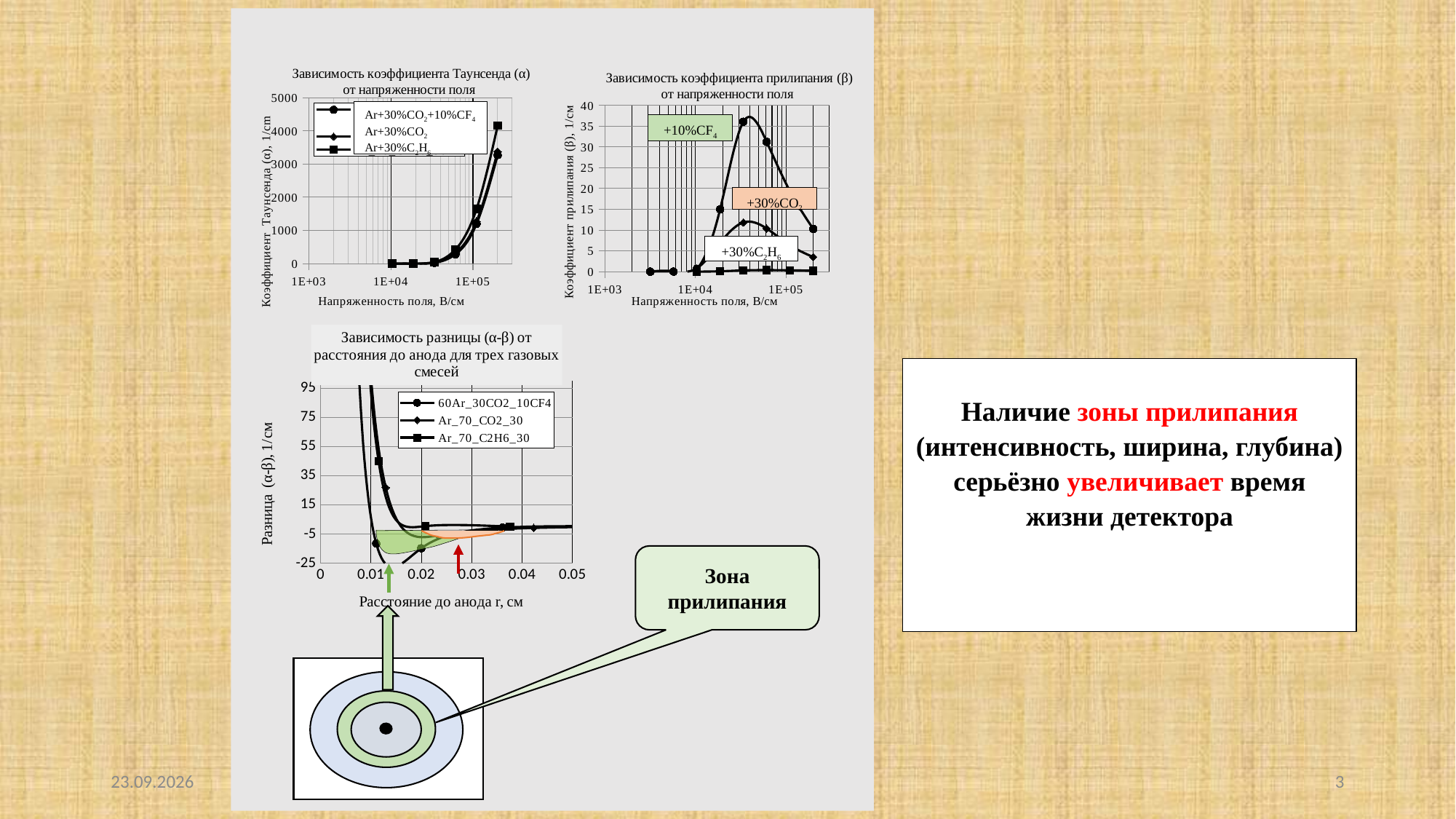
What kind of chart is the top-left chart titled "Зависимость коэффициента Таунсенда (α) от напряженности поля"? Line chart How many series does the legend of the top-left chart (Townsend coefficient α) list? 3 In the top-left chart (Townsend coefficient α), which series reaches the highest value at the right end of the x axis? Ar+30%C2H6 In the top-right chart (attachment coefficient β), is the peak value of the +30%CO2 curve greater or less than 15? less In the top-right chart (attachment coefficient β), is the peak value of the +10%CF4 curve greater or less than 30? greater What is the title of the top-right chart? Зависимость коэффициента прилипания (β) от напряженности поля In the bottom chart (difference α-β), is the value of the Ar_70_C2H6_30 series at r = 0.01 greater or less than 35? greater In the top-right chart (attachment coefficient β), which gas mixture has the highest peak value? +10%CF4 What is the x-axis label of the bottom chart (difference α-β)? Расстояние до анода r, см In the top-left chart (Townsend coefficient α), do the values rise or fall as the field strength increases along the x axis? Rise How many series does the legend of the bottom chart (difference α-β versus distance to anode) list? 3 In the top-right chart (attachment coefficient β), which mixture has the lowest attachment coefficient across the field range? +30%C2H6